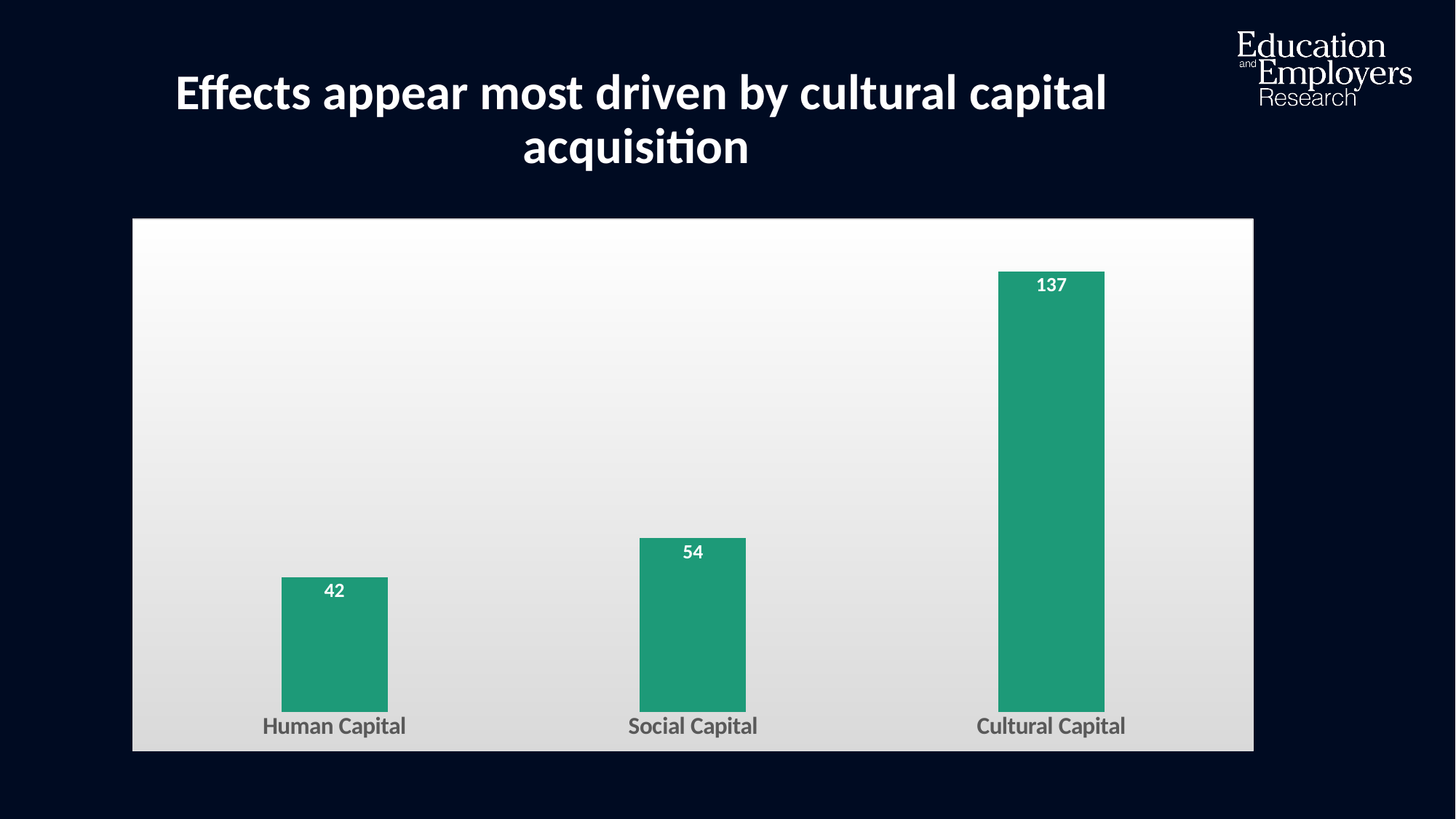
What is the title of the slide? Effects appear most driven by cultural capital acquisition What is the difference between the values for Cultural Capital and Social Capital? 83 Do the values rise or fall from left to right across the categories? Rise What is the value for Cultural Capital? 137 What is the difference between the values for Social Capital and Human Capital? 12 Which category has the lowest value? Human Capital Which is larger, the value for Social Capital or the value for Human Capital? Social Capital What kind of chart is shown on the slide? Bar chart How many categories are shown in the chart? 3 Which category has the highest value? Cultural Capital What is the value for Social Capital? 54 What is the value for Human Capital? 42